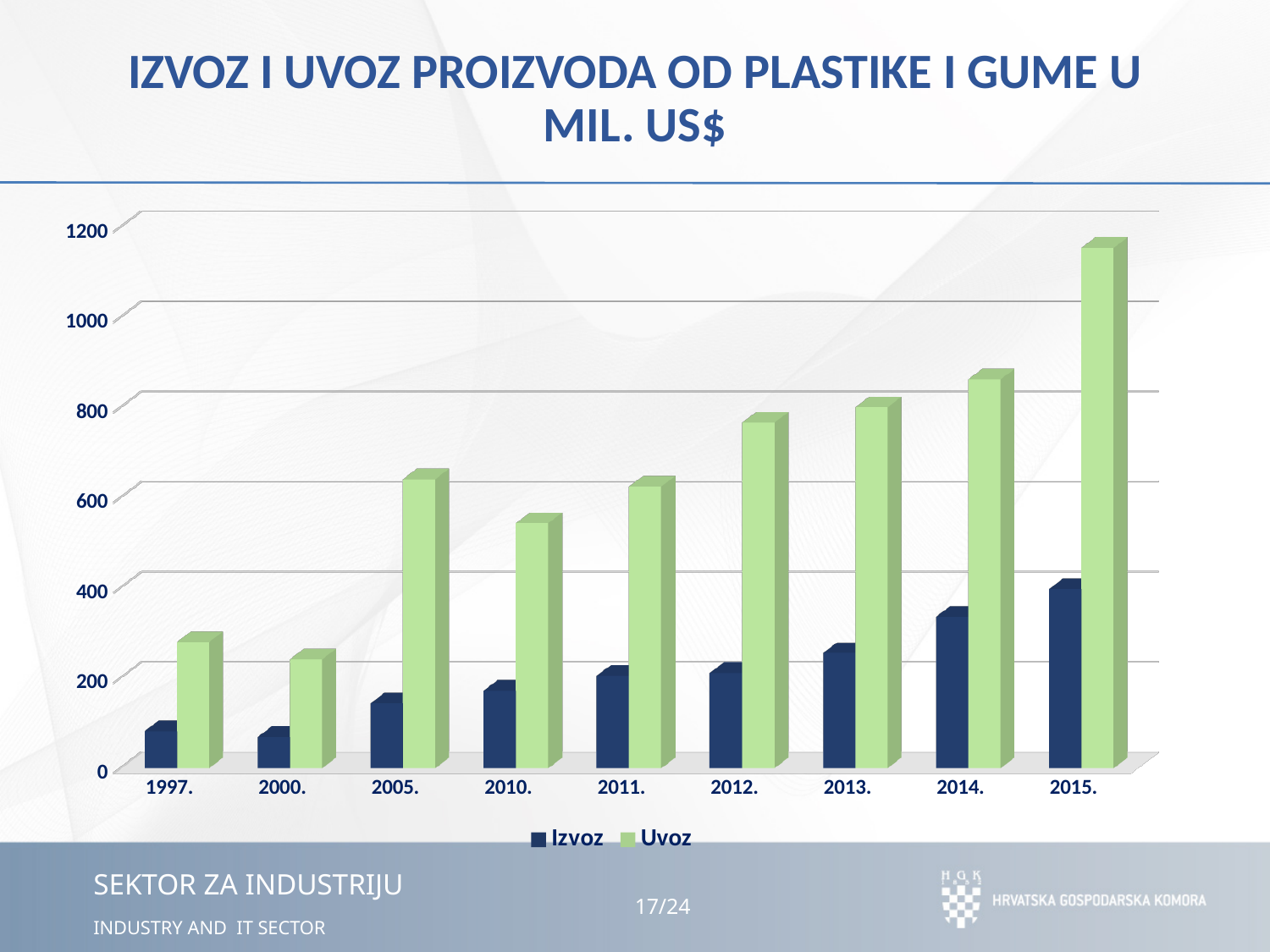
Which year has the lowest Uvoz value? 2000. How many years are shown on the x axis? 9 Do the Uvoz values rise or fall from 2010. to 2015.? rise What are the two series named in the legend? Izvoz and Uvoz Which year has the highest Izvoz value? 2015. How many series does the legend list? 2 What kind of chart is shown on the slide? bar chart Is the Uvoz value for 2010. greater or less than 600? less Is the Uvoz value for 2015. greater or less than 1000? greater Is the Izvoz value for 1997. greater or less than 200? less Which year has the highest Uvoz value? 2015. Which is larger, the Uvoz value for 2005. or for 2010.? 2005.